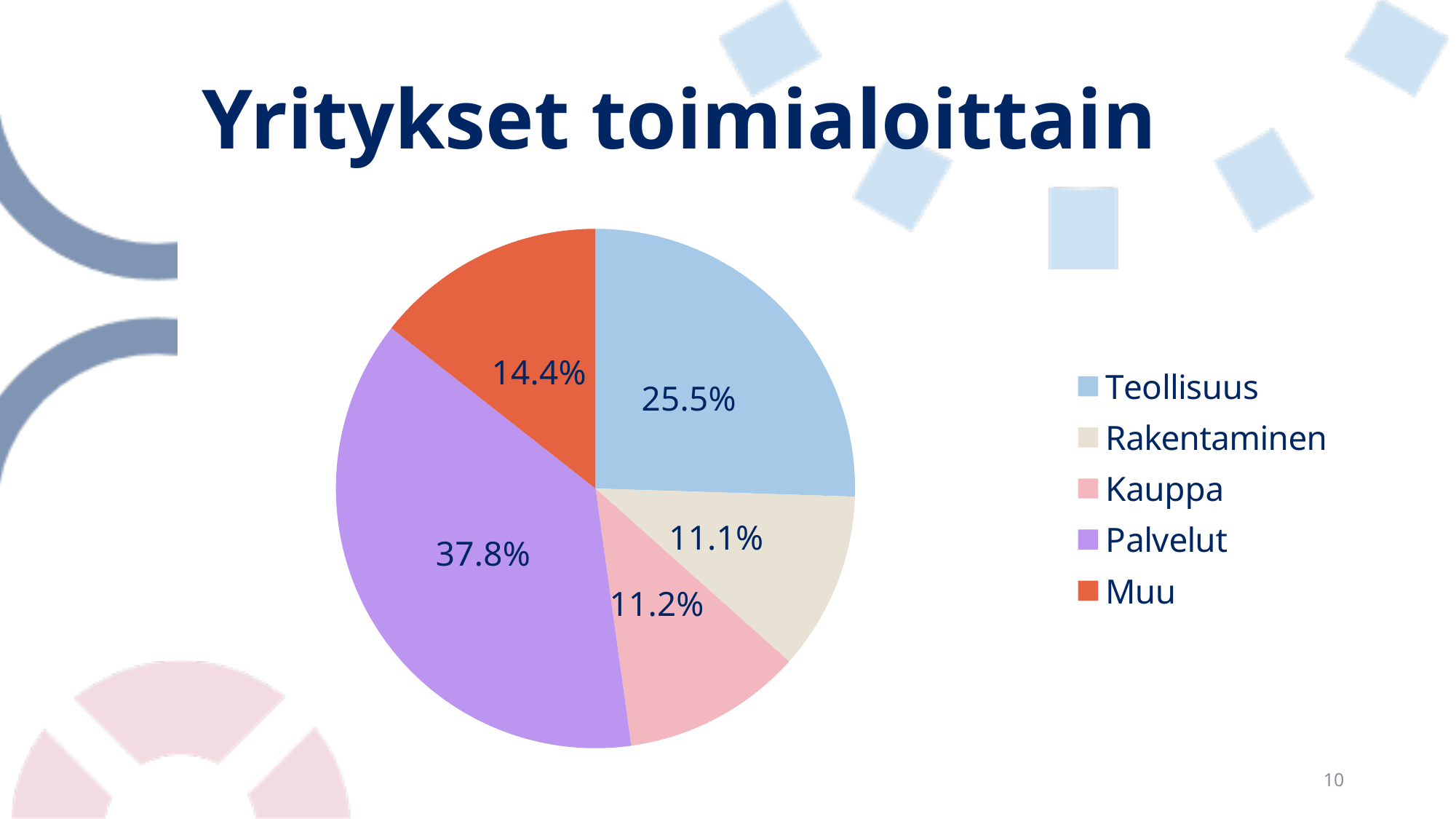
Which is larger, the share for Teollisuus or the share for Muu? Teollisuus What is the value shown for Kauppa? 11.2% Which category has the largest slice of the pie? Palvelut What is the title of the chart on the slide? Yritykset toimialoittain What is the difference in percentage points between Palvelut and Teollisuus? 12.3 What kind of chart is shown on the slide? Pie chart What is the value shown for Rakentaminen? 11.1% What is the value shown for Muu? 14.4% What colour is the Palvelut slice? Purple How many categories does the legend list? 5 What share of the pie does Palvelut have? 37.8% What share of the pie does Teollisuus have? 25.5%